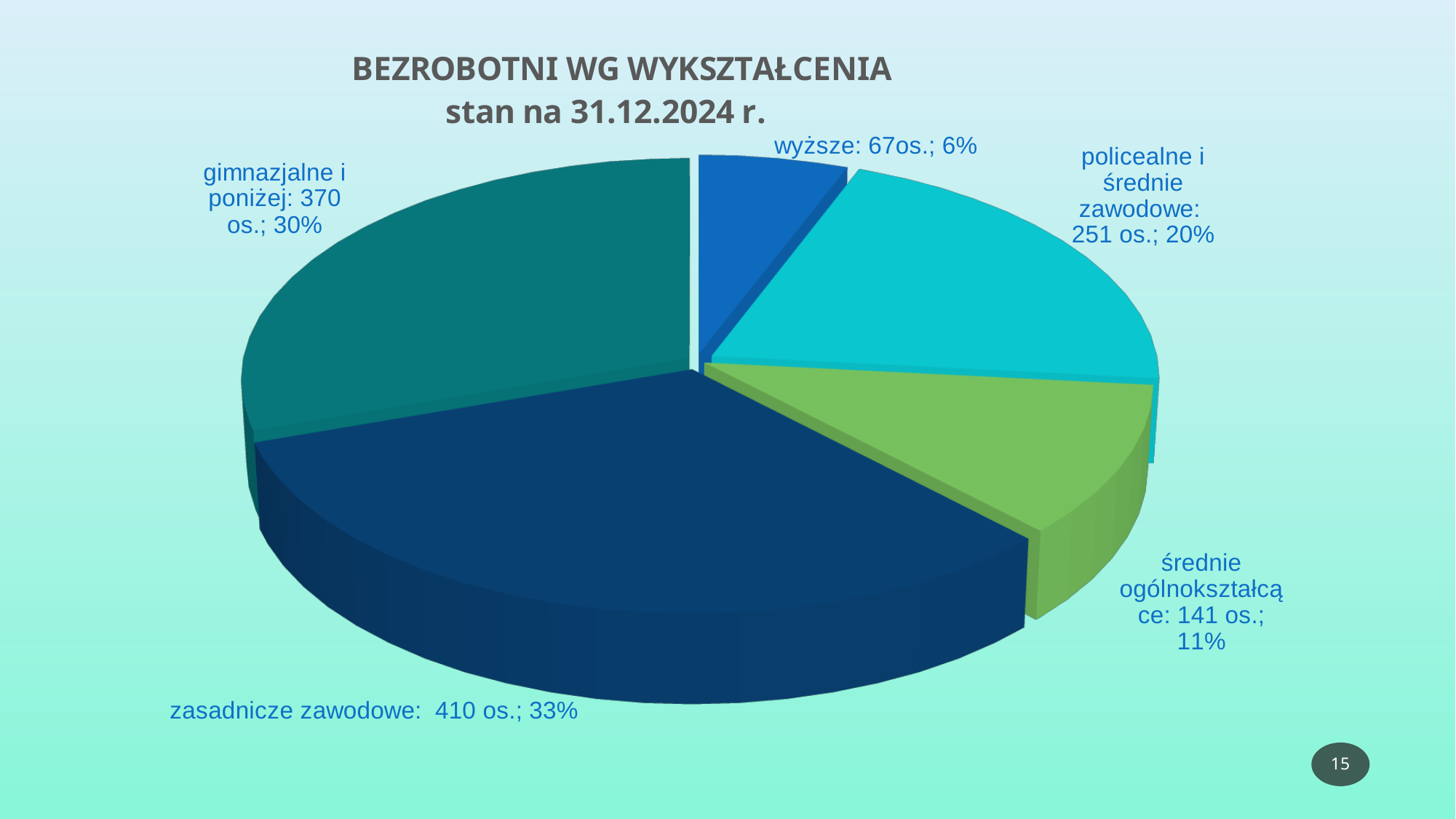
How many slices does the pie chart have? 5 How many people are in the 'policealne i średnie zawodowe' category? 251 os. What share of the pie does 'gimnazjalne i poniżej' represent? 30% Which category has the smallest slice? wyższe How many people are in the 'średnie ogólnokształcące' category? 141 os. What share of the pie does 'zasadnicze zawodowe' represent? 33% What kind of chart is shown on the slide? pie chart Which is larger, 'policealne i średnie zawodowe' or 'średnie ogólnokształcące'? policealne i średnie zawodowe How many people are in the 'wyższe' category? 67 os. What is the difference in number of people between 'zasadnicze zawodowe' and 'gimnazjalne i poniżej'? 40 os. Which category has the largest slice? zasadnicze zawodowe What date is given in the chart title? 31.12.2024 r.